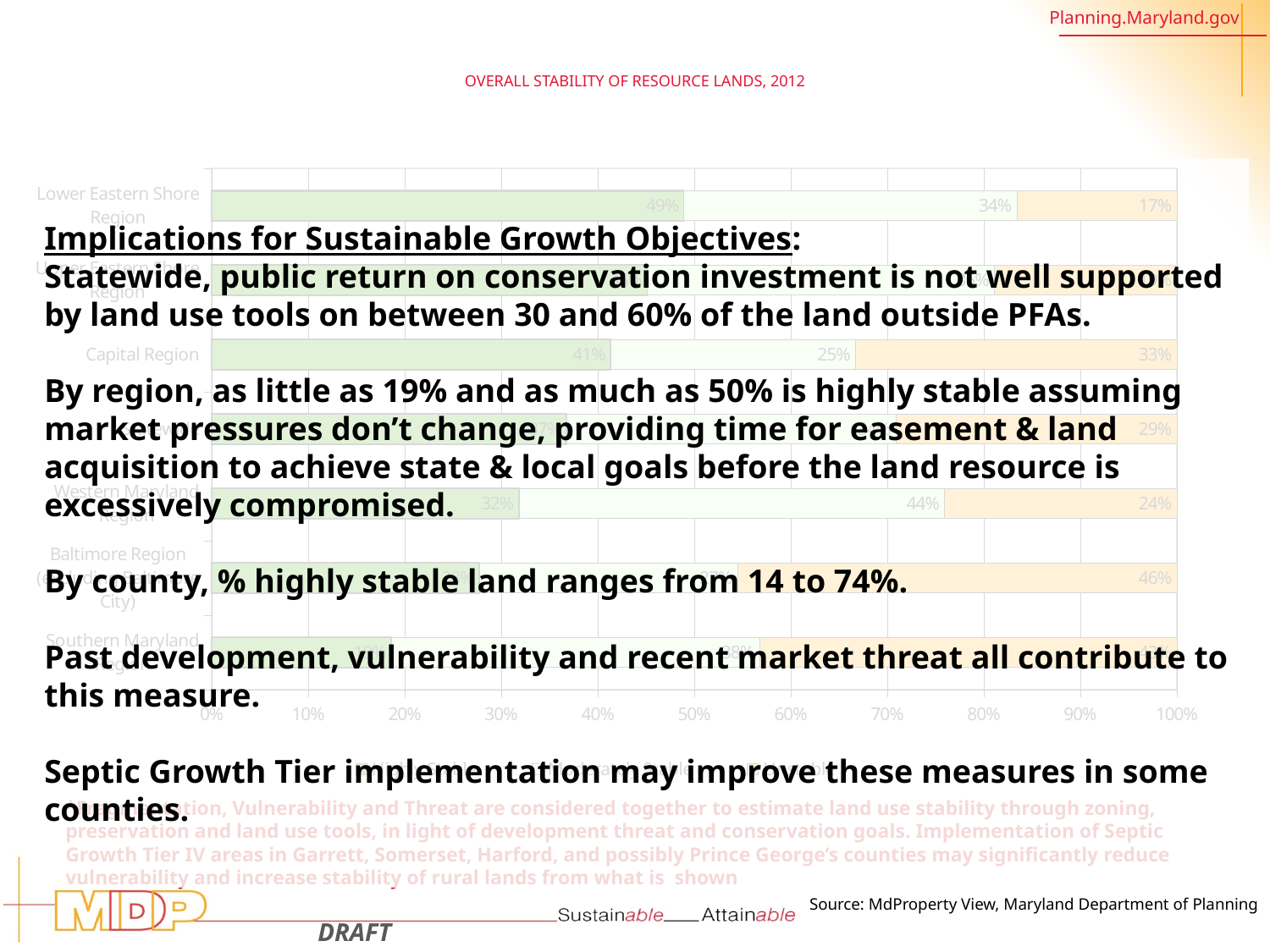
How many region bars are shown in the chart? 7 What is the value of the last (orange) segment for the Western Maryland Region? 24% Which has a larger first (dark green) segment: the Lower Eastern Shore Region or the Western Maryland Region? Lower Eastern Shore Region What is the value of the first (dark green) segment for the Lower Eastern Shore Region? 49% What is the title of the chart? OVERALL STABILITY OF RESOURCE LANDS, 2012 What is the total of the three segments for the Lower Eastern Shore Region? 100% What is the value of the middle (light green) segment for the Western Maryland Region? 44% What is the difference between the first segment of the Lower Eastern Shore Region (49%) and the first segment of the Capital Region (41%)? 8 percentage points What is the value of the first (dark green) segment for the Capital Region? 41% What is the value of the last (orange) segment for the Lower Eastern Shore Region? 17% What is the value of the last (orange) segment for the Capital Region? 33% What kind of chart is shown on the slide? bar chart